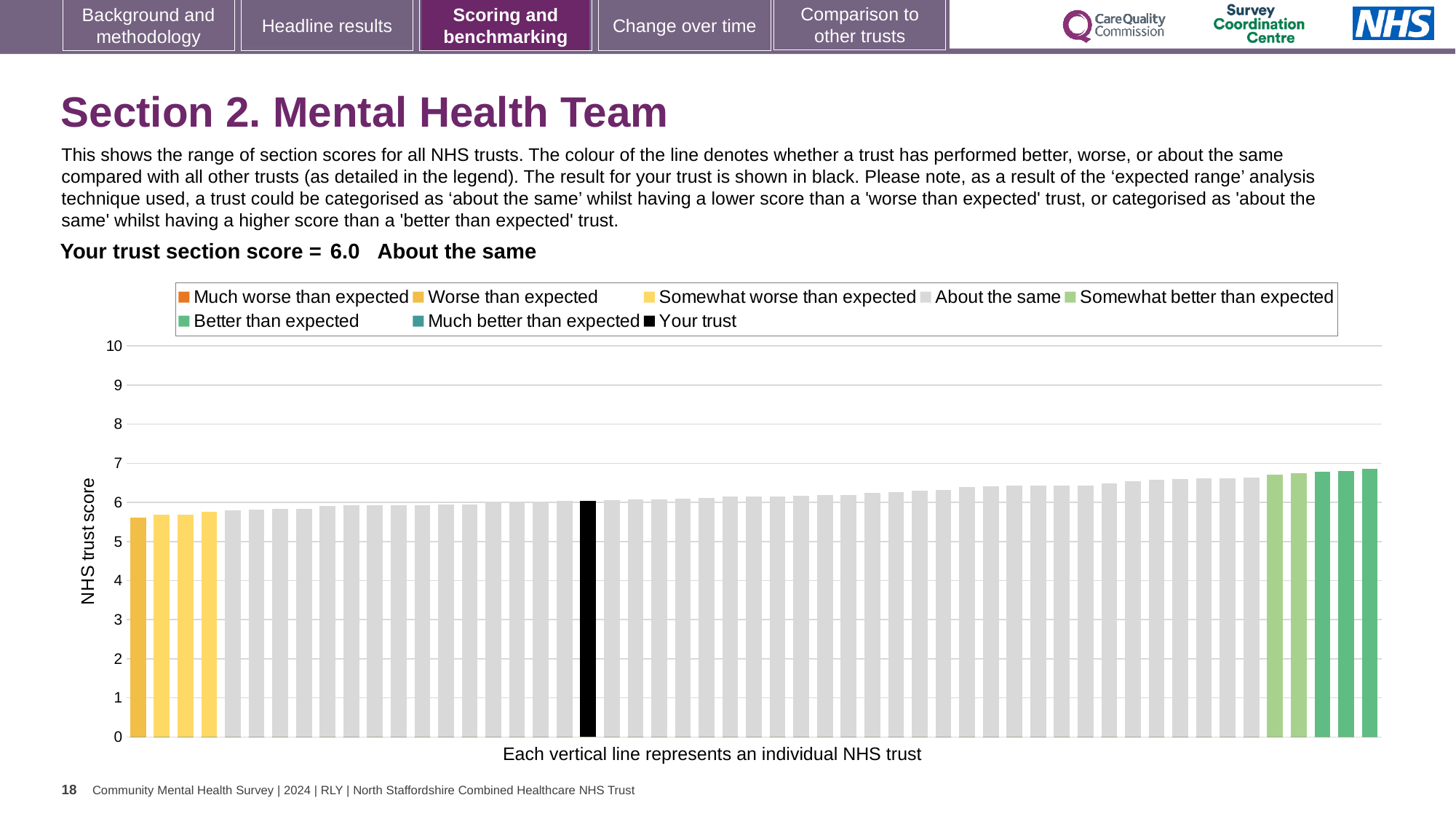
What kind of chart is shown on the slide? Bar chart Is the value of the lowest bar in the chart greater or less than 6? less Which legend category do the bars with the highest scores belong to? Better than expected How many entries does the chart legend list? 8 Which legend category do the bars with the lowest scores belong to? Worse than expected Is the value of the black bar for your trust greater or less than 5? greater What is the section score for your trust shown on the slide? 6.0 How is your trust categorised compared with other trusts for this section? About the same Do the bar values rise or fall from left to right across the chart? Rise Is the value of the highest bar in the chart greater or less than 7? less What is the label on the vertical axis of the chart? NHS trust score